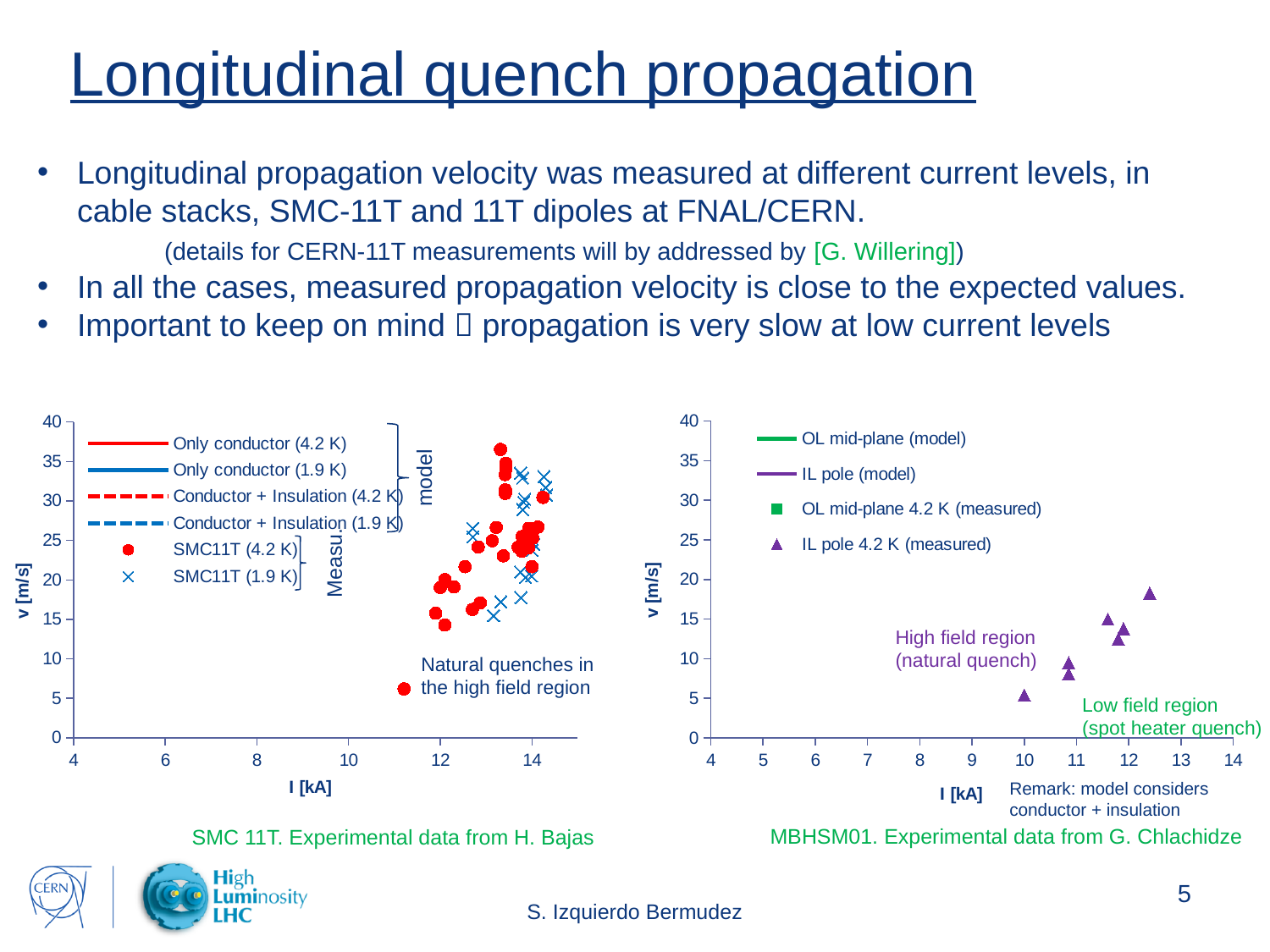
What is the label of the x axis on the left chart (SMC 11T)? I [kA] How many series does the legend of the left chart (SMC 11T) list? 6 In the right chart (MBHSM01), is the highest IL pole 4.2 K (measured) value greater or less than 15? greater In the right chart (MBHSM01), is the lowest IL pole 4.2 K (measured) value greater or less than 10? less In the left chart (SMC 11T), is the lowest SMC11T (4.2 K) measured value greater or less than 20? less How many series does the legend of the right chart (MBHSM01) list? 4 In the left chart (SMC 11T), do the measured SMC11T (4.2 K) values generally rise or fall as the current I increases? rise What kind of chart is the right chart (MBHSM01)? scatter chart In the right chart (MBHSM01), do the IL pole 4.2 K (measured) values generally rise or fall as the current I increases? rise What kind of chart is the left chart (SMC 11T)? scatter chart What is the label of the y axis on the right chart (MBHSM01)? v [m/s]